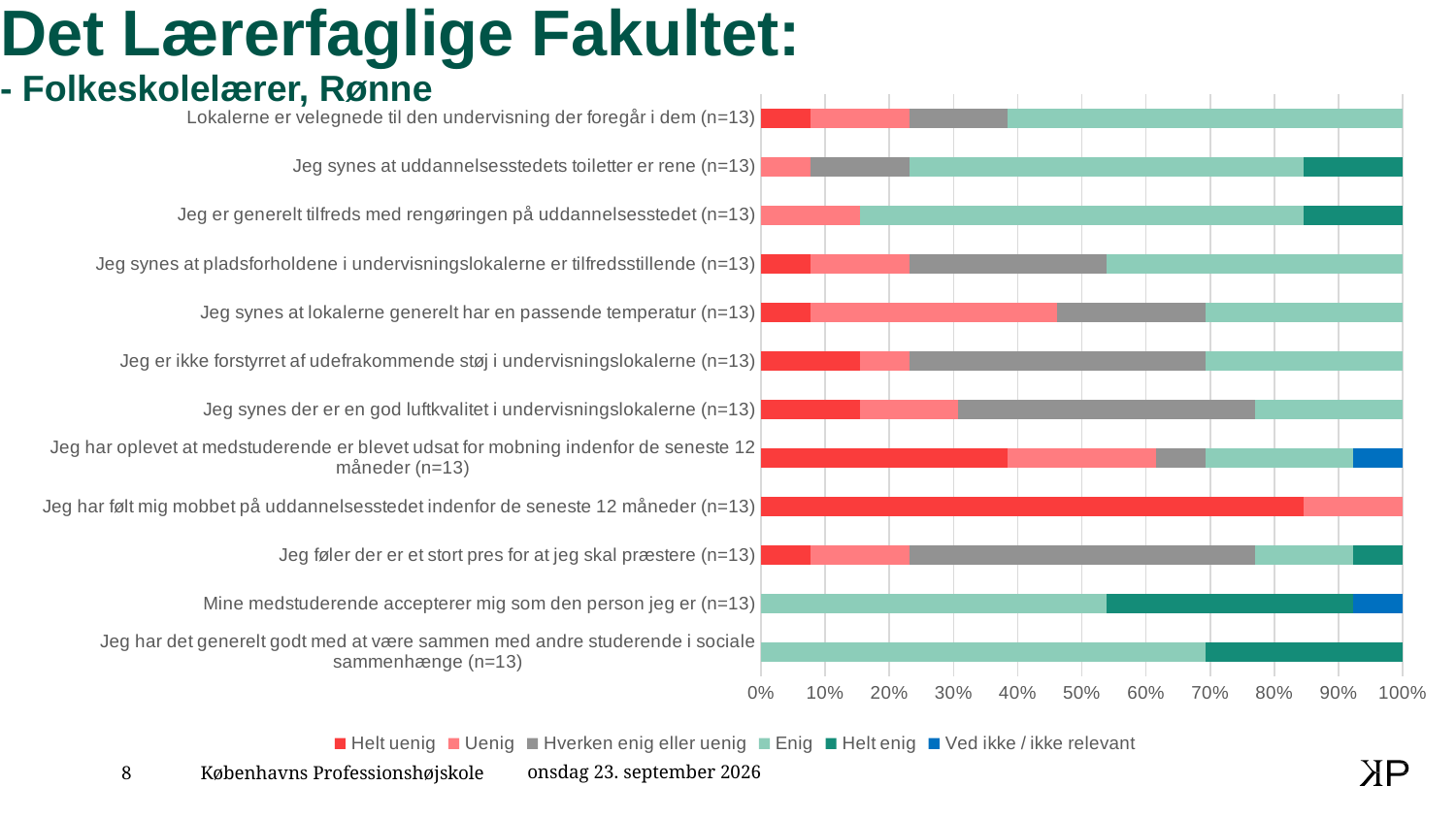
Is the 'Uenig' share for 'Jeg synes at lokalerne generelt har en passende temperatur (n=13)' greater or less than 30%? greater Which statement has the largest 'Helt uenig' share? Jeg har følt mig mobbet på uddannelsesstedet indenfor de seneste 12 måneder (n=13) Is the 'Helt enig' share for 'Jeg er generelt tilfreds med rengøringen på uddannelsesstedet (n=13)' greater or less than 20%? less What is the sample size (n) shown for each statement in the chart? 13 Which has the larger 'Helt uenig' share: 'Jeg har følt mig mobbet på uddannelsesstedet indenfor de seneste 12 måneder (n=13)' or 'Jeg har oplevet at medstuderende er blevet udsat for mobning indenfor de seneste 12 måneder (n=13)'? Jeg har følt mig mobbet på uddannelsesstedet indenfor de seneste 12 måneder (n=13) Is the 'Helt uenig' share for 'Jeg har følt mig mobbet på uddannelsesstedet indenfor de seneste 12 måneder (n=13)' greater or less than 80%? greater How many statements (categories) are plotted in the chart? 12 Which legend entry is shown in blue? Ved ikke / ikke relevant What kind of chart is shown on the slide? Stacked bar chart How many series does the legend list? 6 How many statements include a 'Ved ikke / ikke relevant' segment? 2